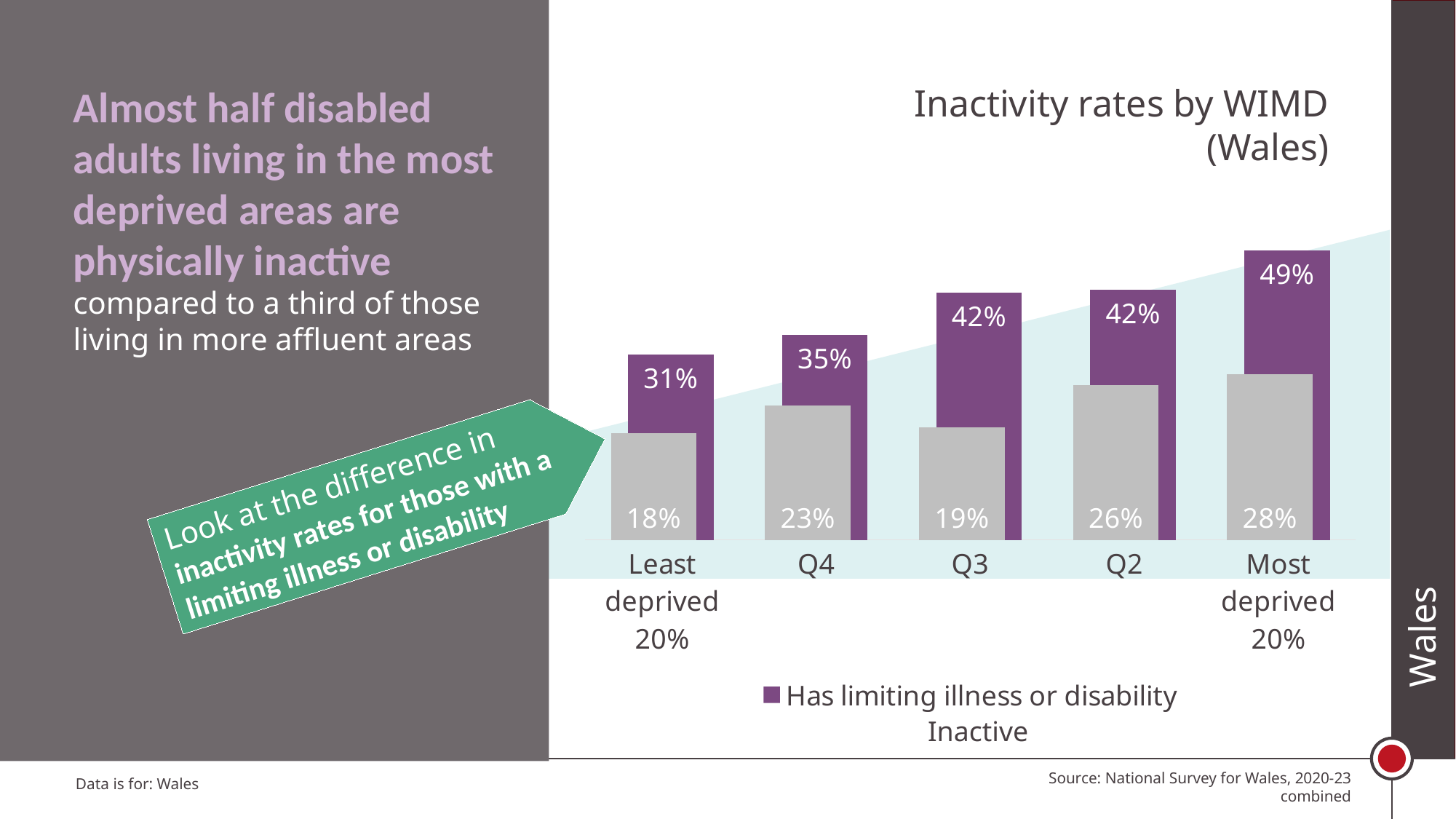
Which category has the lowest value for the grey bars? Least deprived 20% What is the value of the grey bar for the Least deprived 20% category? 18% What is the value of the purple bar (Has limiting illness or disability) for Q4? 35% What is the inactivity rate for those with a limiting illness or disability in the Most deprived 20% areas? 49% Which category has the highest value for the 'Has limiting illness or disability' series? Most deprived 20% How many categories are shown on the x axis? 5 Which is larger: the grey bar for Q4 or the grey bar for Q3? Q4 What type of chart is shown on the slide? Bar chart What is the title of the chart? Inactivity rates by WIMD (Wales) What is the difference between the 'Has limiting illness or disability' values for the Most deprived 20% and the Least deprived 20%? 18 percentage points What is the value of the grey bar for Q2? 26% What is the difference between the purple bar and the grey bar for the Most deprived 20% category? 21 percentage points